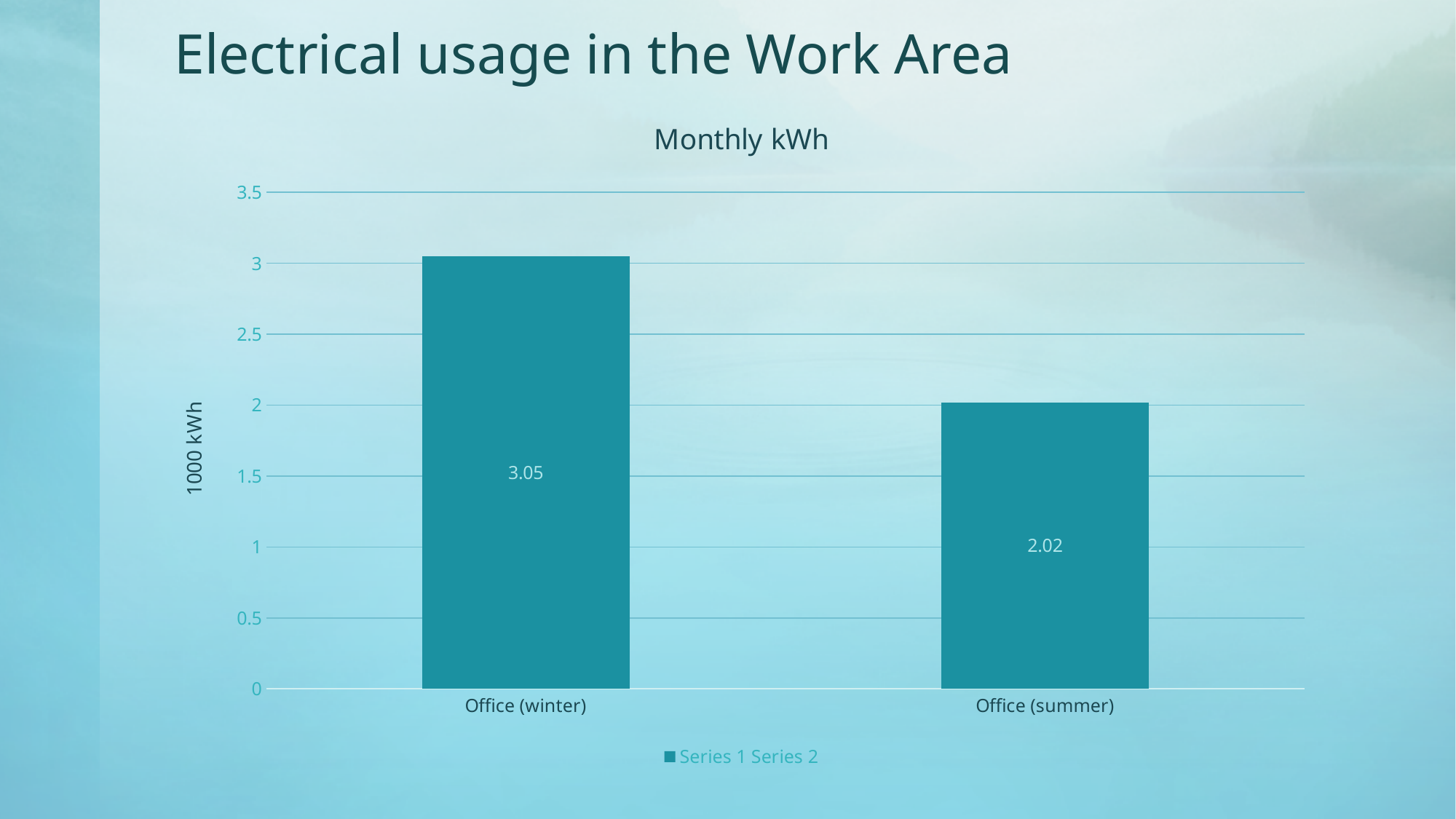
What kind of chart is shown on the slide? bar chart Which category has the lowest value? Office (summer) Which is larger, the value for Office (winter) or Office (summer)? Office (winter) What is the value for Office (summer)? 2.02 How many categories are shown on the x axis? 2 Which category has the highest value? Office (winter) What is the label on the vertical axis? 1000 kWh What is the difference between the Office (winter) and Office (summer) values? 1.03 Is the value for Office (winter) greater or less than 3? greater What is the title of the chart? Monthly kWh Is the value for Office (summer) greater or less than 2.5? less What is the value for Office (winter)? 3.05